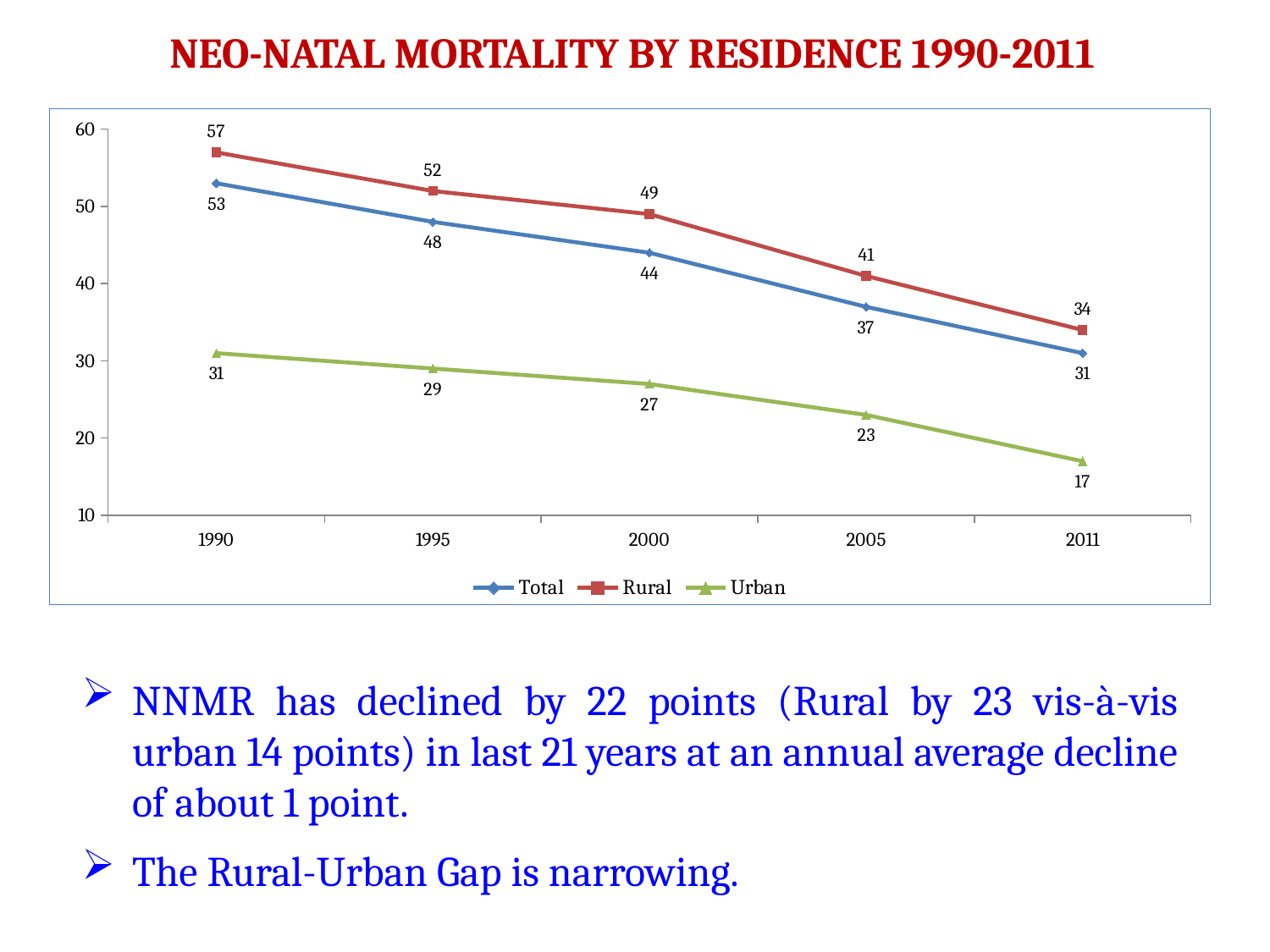
What is the Urban neo-natal mortality value in 2011? 17 What is the Total neo-natal mortality value in 2000? 44 In which year is the Urban series at its lowest? 2011 Do the Urban values rise or fall from 1990 to 2011? Fall How many years are shown on the x axis? 5 What is the difference between the Rural and Urban values in 2005? 18 How many series does the legend list? 3 By how much did the Total value decline from 1990 to 2011? 22 What kind of chart is shown on the slide? Line chart Which is larger in 1995, the Rural value or the Total value? Rural In which year is the Rural series at its highest? 1990 What is the Rural neo-natal mortality value in 1990? 57